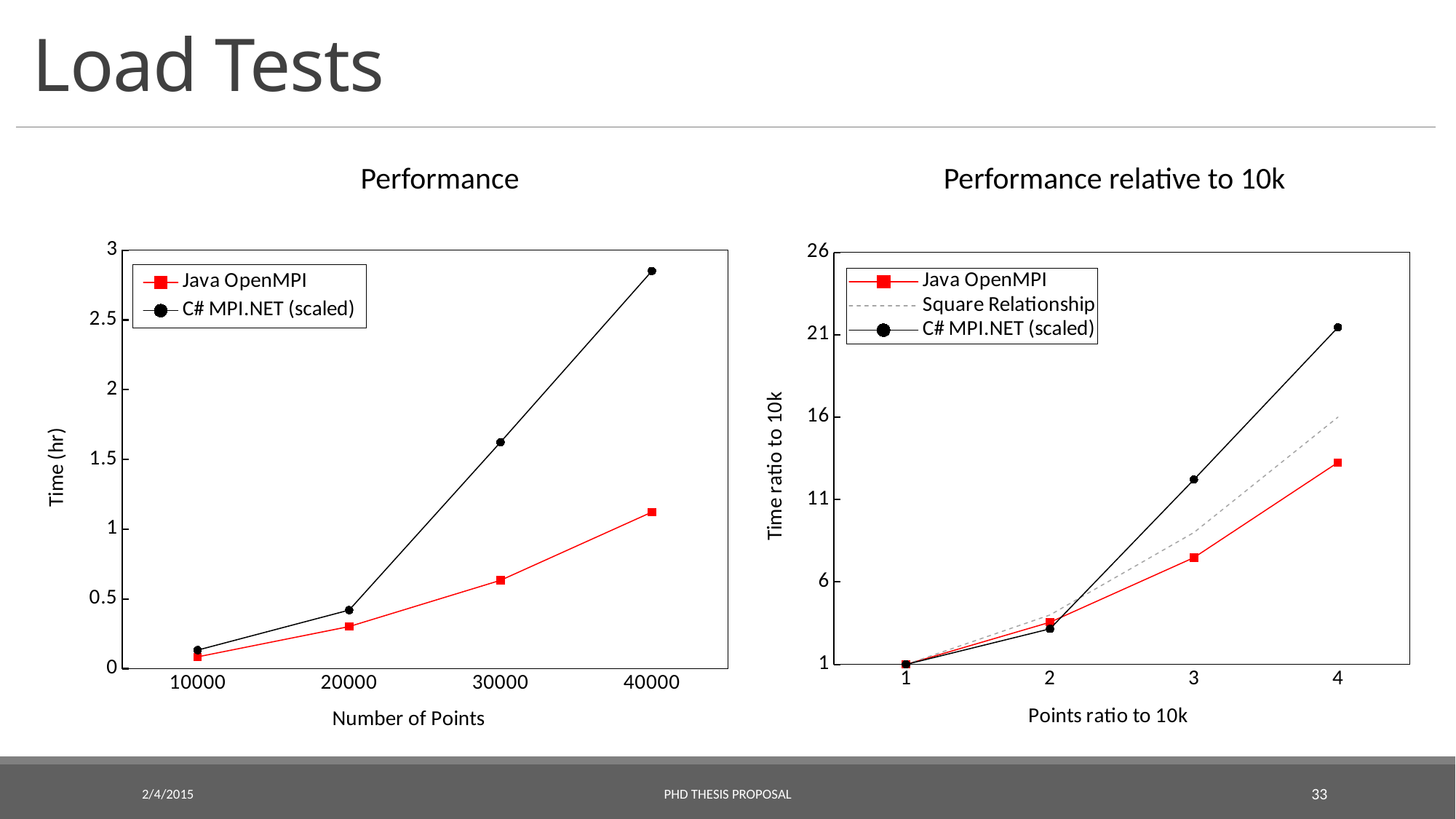
In the 'Performance relative to 10k' chart, how many series does the legend list? 3 In the 'Performance relative to 10k' chart, is the time ratio for C# MPI.NET (scaled) at a points ratio of 3 greater or less than 11? greater What kind of chart is the 'Performance' chart on the left? Line chart In the 'Performance' chart, how many Number of Points values are plotted along the x axis? 4 In the 'Performance' chart, how many series does the legend list? 2 In the 'Performance relative to 10k' chart, which series has the highest time ratio at a points ratio of 4? C# MPI.NET (scaled) In the 'Performance' chart, which series has the higher time at 30000 points? C# MPI.NET (scaled) In the 'Performance relative to 10k' chart, is the time ratio for Java OpenMPI at a points ratio of 4 greater or less than 16? less In the 'Performance' chart, does the Java OpenMPI time rise or fall as the number of points increases? Rises In the 'Performance' chart, is the time for C# MPI.NET (scaled) at 40000 points greater or less than 2.5 hr? greater What is the x-axis title of the 'Performance relative to 10k' chart? Points ratio to 10k